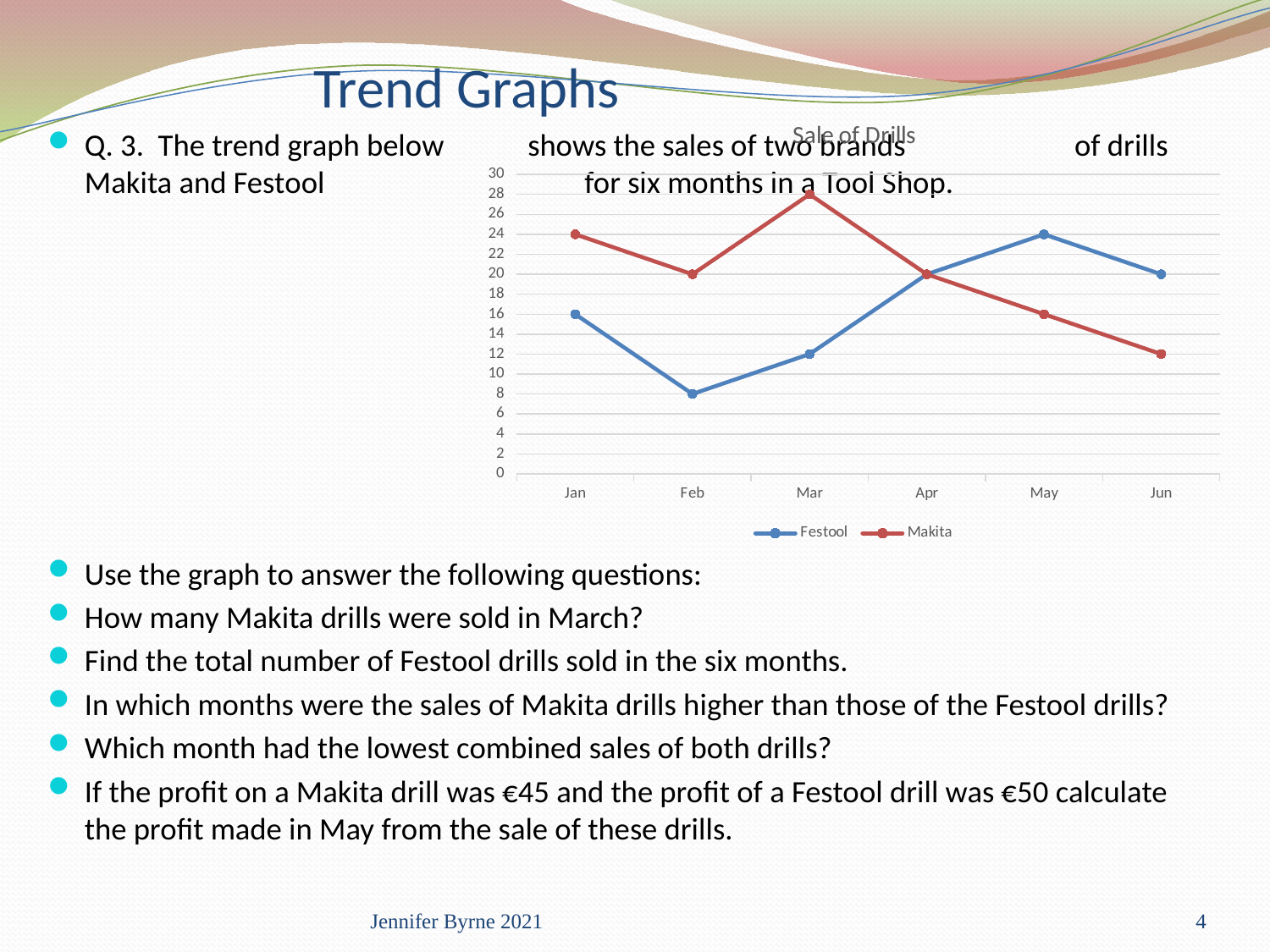
What is the difference between the Makita and Festool values in Mar? 16 How many series does the legend of the chart list? 2 Does the Makita series rise or fall from Apr to Jun? fall What is the value for Festool in Feb? 8 What is the value for Makita in Mar? 28 Which series is drawn in red in the chart? Makita What kind of chart is shown on the slide? line chart Which series has the larger value in May, Festool or Makita? Festool In which month is the Festool series at its lowest? Feb How many months are shown on the x axis of the chart? 6 What is the value for Festool in May? 24 In which month is the Makita series at its highest? Mar